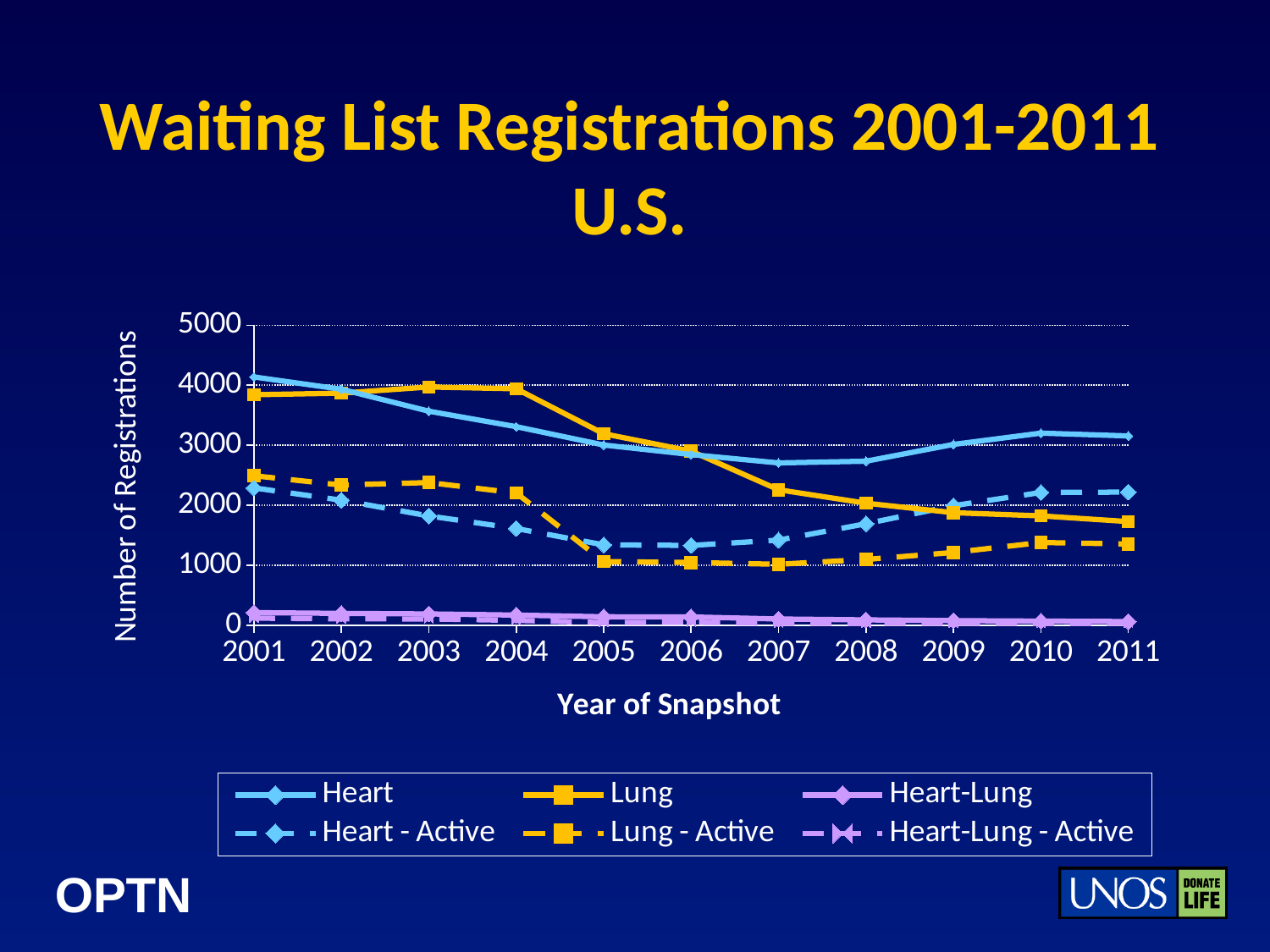
Is the value for Lung in 2011 greater or less than 2000? less What is the title of the x axis? Year of Snapshot In 2011, which is larger, the value for Heart or the value for Lung? Heart Is the value for Heart - Active in 2004 greater or less than 2000? less Is the value for Heart-Lung in 2001 greater or less than 1000? less How many years are plotted along the x axis? 11 How many series does the legend list? 6 Which series has the highest value in 2011? Heart Does the Lung series rise or fall from 2001 to 2011? fall What kind of chart is shown on the slide? line chart